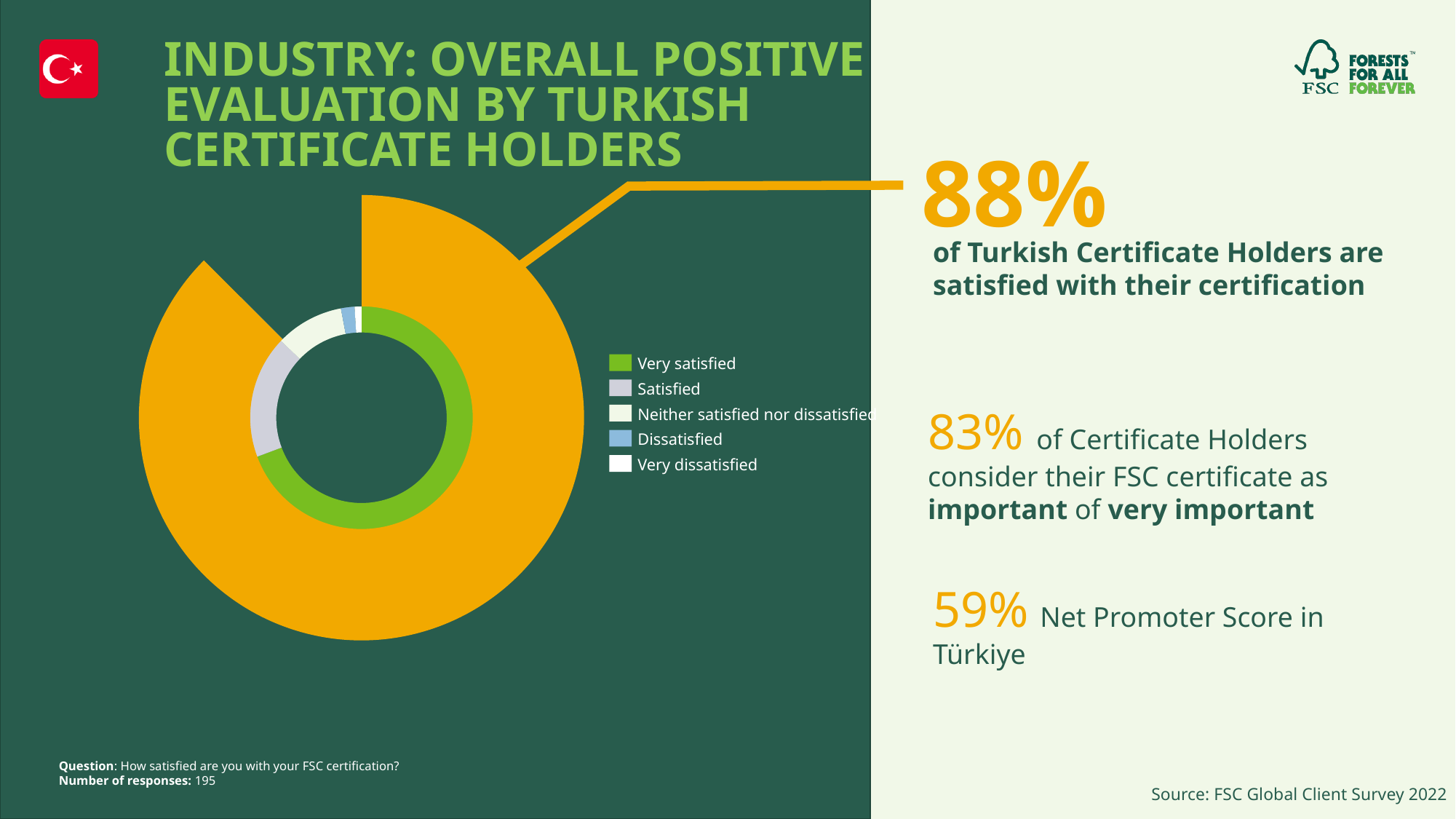
Which slice is larger in the donut chart, Very satisfied or Satisfied? Very satisfied Which category has the largest slice in the donut chart? Very satisfied What is the number of responses stated for the survey question shown with the chart? 195 What kind of chart is shown on the slide? Donut (pie) chart According to the callout linked to the donut chart, what percentage of Turkish Certificate Holders are satisfied with their certification? 88% Which slice is larger in the donut chart, Satisfied or Neither satisfied nor dissatisfied? Satisfied How many categories does the legend of the donut chart list? 5 Which slice is larger in the donut chart, Neither satisfied nor dissatisfied or Dissatisfied? Neither satisfied nor dissatisfied What colour represents the Very satisfied category in the donut chart? Green